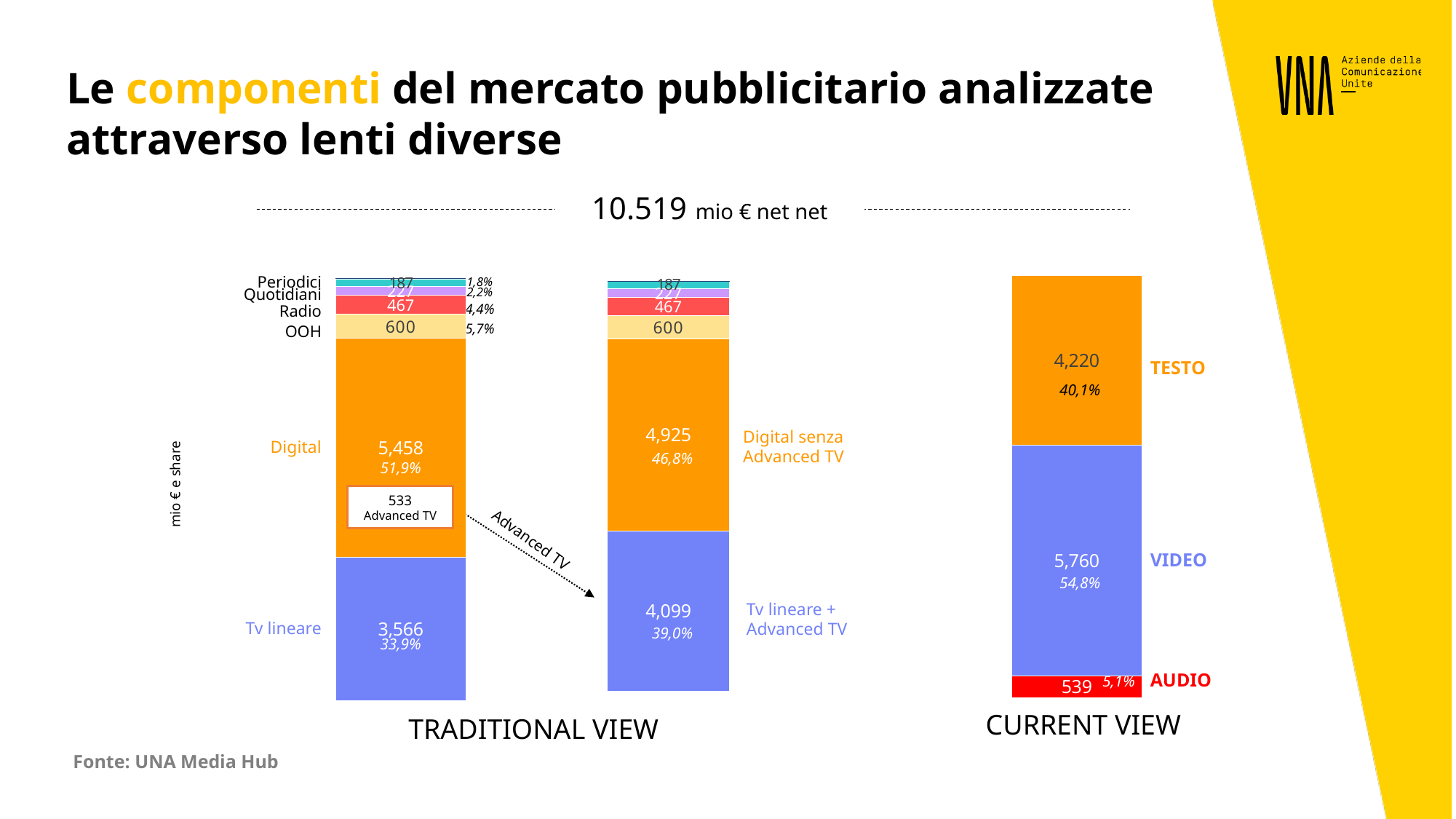
In the Traditional View chart, what is the value for Digital senza Advanced TV? 4,925 In the Traditional View chart, what is the value for Tv lineare + Advanced TV in the second bar? 4,099 In the Traditional View chart, what is the value for Advanced TV? 533 In the Traditional View chart, what is the value for Radio? 467 In the Current View chart, what share does TESTO represent? 40,1% What kind of chart is shown on the slide? Stacked bar chart In the Current View chart, what is the value for VIDEO? 5,760 In the Traditional View chart, what is the value for OOH? 600 In the Traditional View chart, what share does Tv lineare represent in the first bar? 33,9% In the Traditional View chart, what is the value for Digital in the first bar? 5,458 In the Current View chart, what is the difference between VIDEO and TESTO? 1,540 In the Current View chart, which segment is the smallest? AUDIO